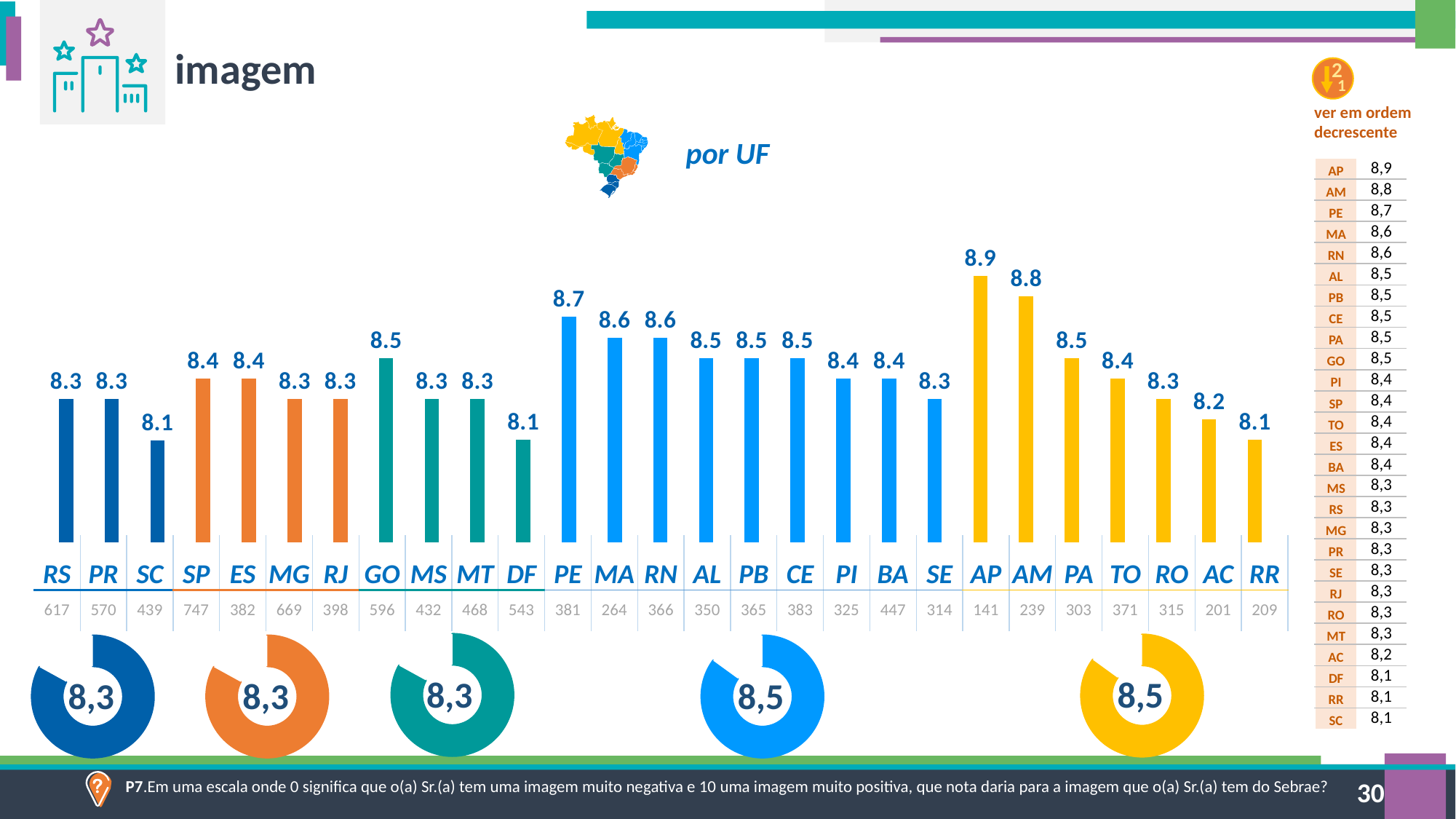
What kind of chart shows the values by UF? Bar chart What is the value for PE in the bar chart? 8.7 Which has a larger value, AC or PA? PA Which has a larger value, MA or PI? MA What is the difference between the values for PE and SP? 0.3 What is the value for GO in the bar chart? 8.5 What is the lowest value shown in the bar chart? 8.1 What is the difference between the values for AP and RR? 0.8 Which UF has the highest value in the bar chart? AP What is the value for SC in the bar chart? 8.1 How many UFs are shown in the bar chart? 27 What is the value for AM in the bar chart? 8.8